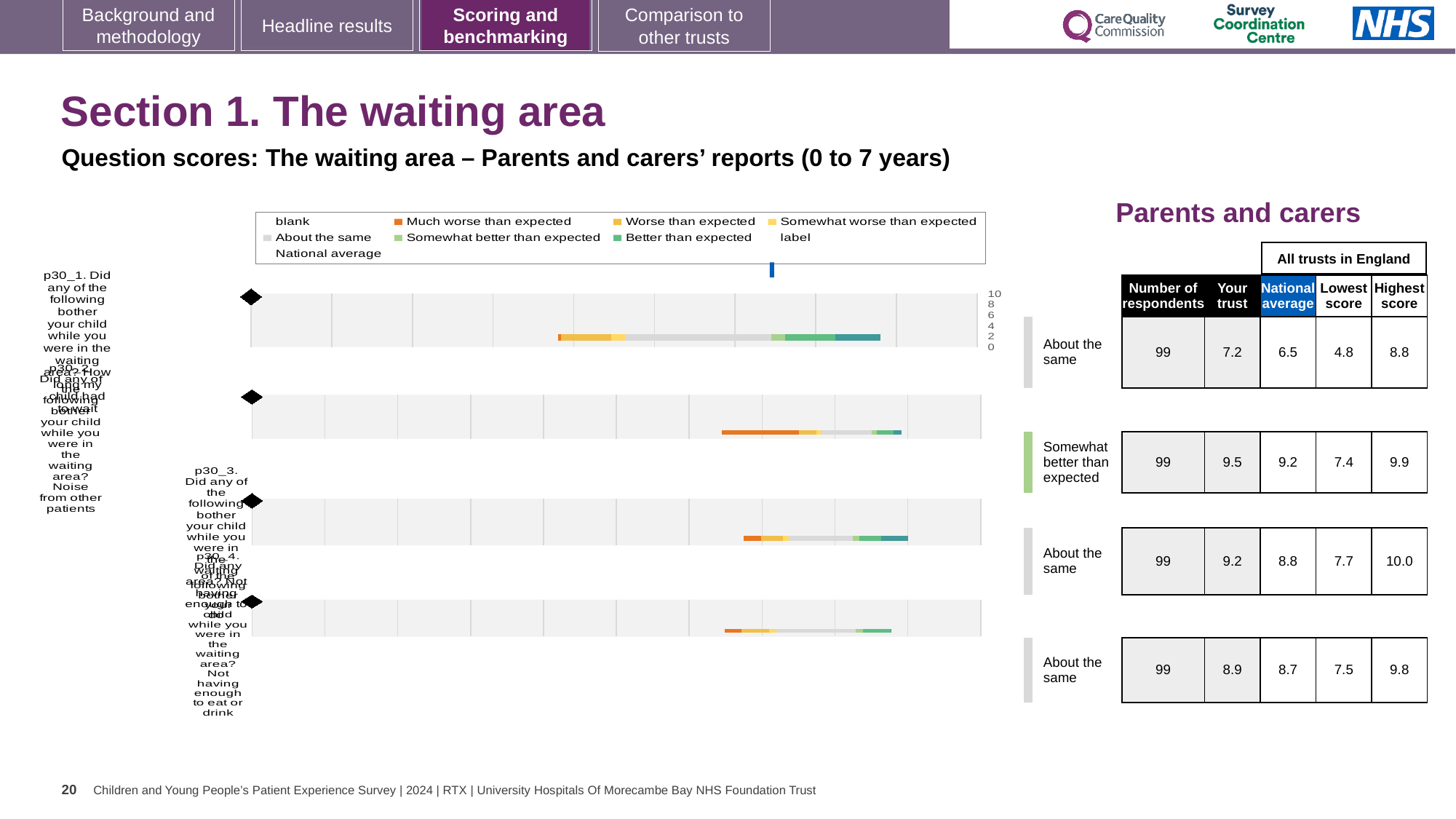
What is the subtitle of the chart section on the slide? Question scores: The waiting area – Parents and carers' reports (0 to 7 years) In the table beside the chart, what is the 'Your trust' score in the first row (About the same)? 7.2 What kind of chart is shown on the slide? bar chart In the table beside the chart, what is the 'National average' in the second row (Somewhat better than expected)? 9.2 In the table beside the chart, what is the 'Highest score' in the third row? 10.0 How many question bars are plotted in the chart? 4 In the table beside the chart, what is the difference between 'Your trust' and 'National average' in the first row? 0.7 In the table beside the chart, which row has the highest 'Your trust' score? the second row (Somewhat better than expected), 9.5 How many entries does the chart legend list? 9 In the table beside the chart, what is the 'Lowest score' in the fourth row? 7.5 What colour represents 'Much worse than expected' in the chart legend? orange In the table beside the chart, how many respondents are listed for each row? 99